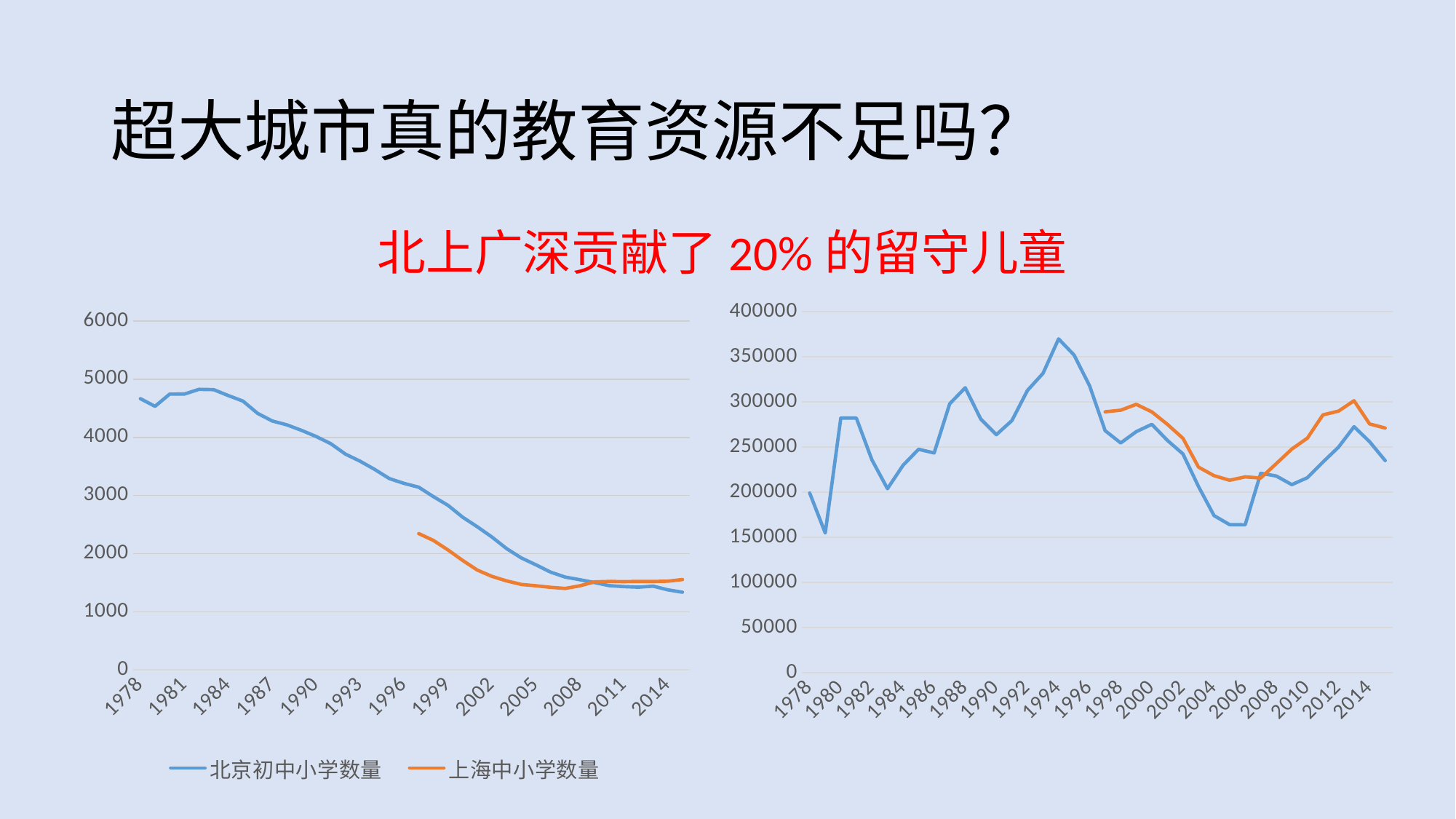
How many series does the legend of the left chart list? 2 In the right chart, in which year does the blue line reach its highest value? 1994 In the right chart, is the peak value of the blue line in 1994 greater or less than 350000? greater In the left chart, is the value for 北京初中小学数量 in 1978 greater or less than 4000? greater In the right chart, is the value of the blue line in 2006 greater or less than 200000? less In the right chart, which line is higher in 2004, the blue line or the orange line? the orange line In the left chart, does the 北京初中小学数量 line rise or fall overall from 1978 to 2014? fall What kind of chart is the chart on the left of the slide? line chart In the left chart, which series is drawn in orange? 上海中小学数量 In the left chart, is the 北京初中小学数量 value larger in 1978 or in 2014? 1978